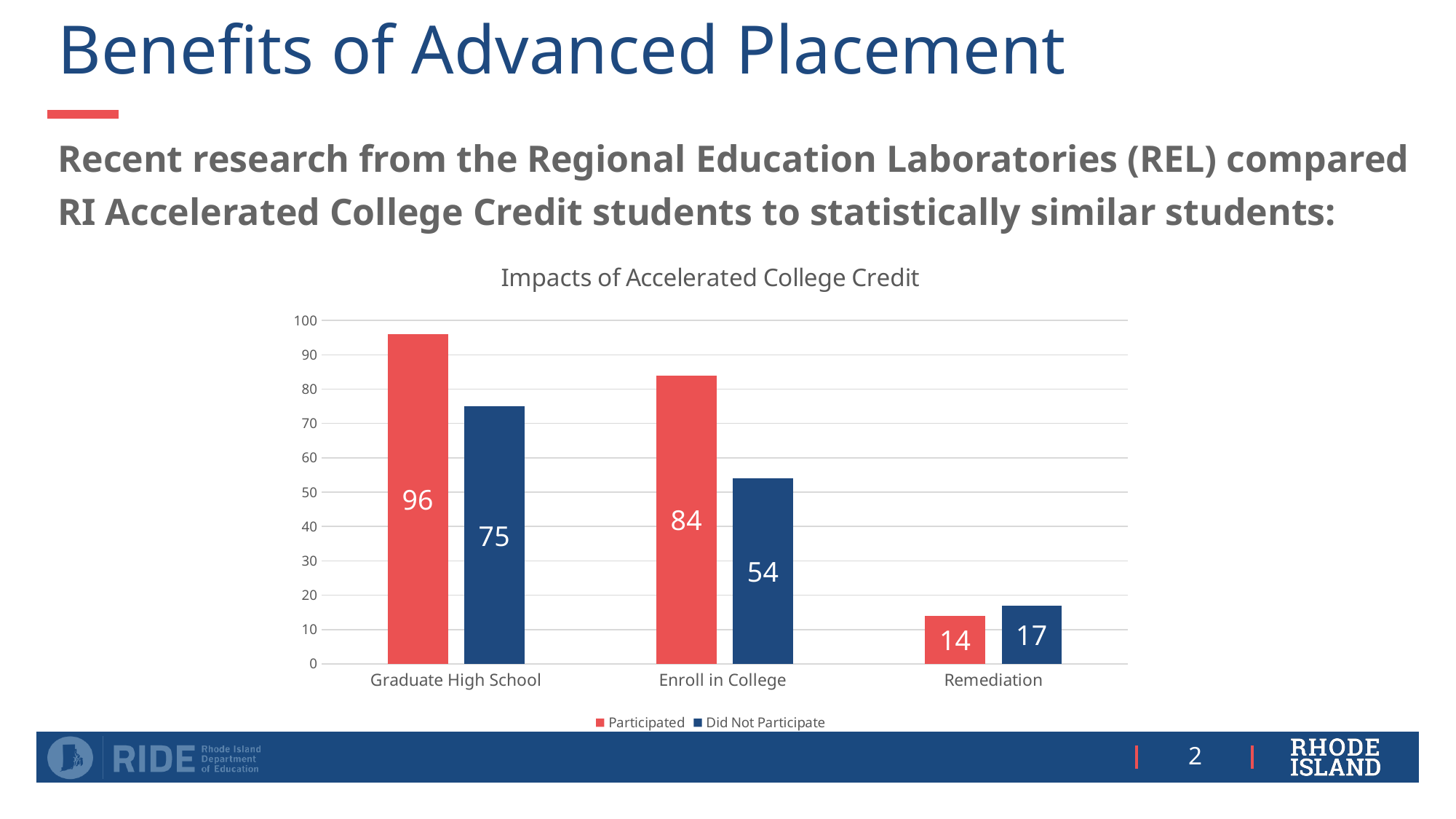
What is the title of the chart? Impacts of Accelerated College Credit Which category has the lowest value for the Did Not Participate series? Remediation What is the value for Did Not Participate in the Enroll in College category? 54 Is the value for Did Not Participate in the Graduate High School category greater or less than 80? less How many categories are shown on the x axis? 3 How many series does the legend list? 2 What is the difference between Participated and Did Not Participate in the Enroll in College category? 30 In the Remediation category, which series has the larger value, Participated or Did Not Participate? Did Not Participate What is the value for Participated in the Remediation category? 14 What kind of chart is shown on the slide? bar chart What is the value for Participated in the Graduate High School category? 96 Which category has the highest value for the Participated series? Graduate High School